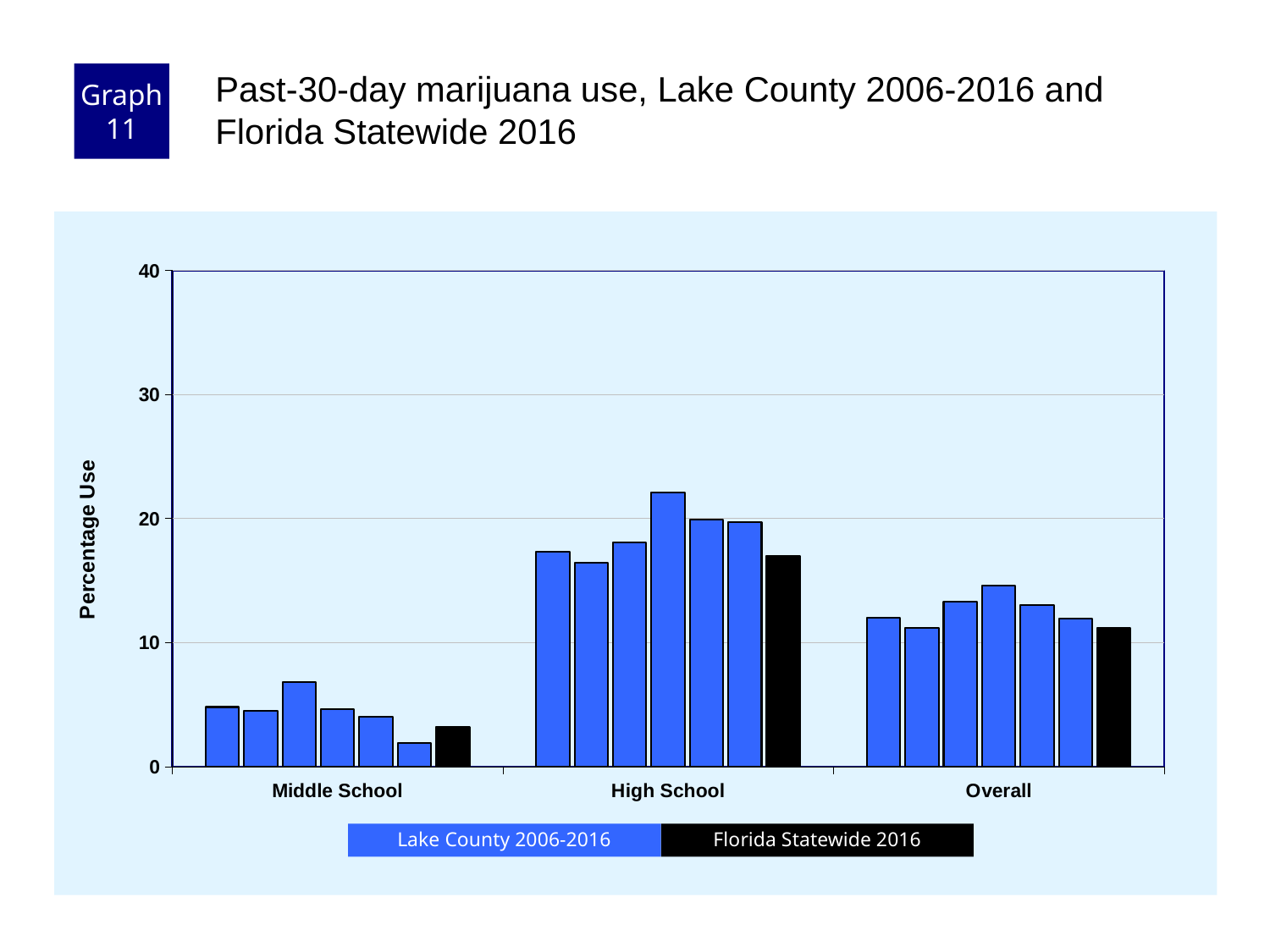
How many series does the legend list? 2 Do the Lake County 2006-2016 bars for Middle School end higher or lower than they start? lower Is the Florida Statewide 2016 value for Overall greater or less than 10? greater Which category has the lowest bars overall? Middle School Is the Florida Statewide 2016 value for High School greater or less than 20? less What is the label on the y axis? Percentage Use How many categories are shown on the x axis? 3 Which category has the highest bars overall? High School Which is larger, the Florida Statewide 2016 value for High School or for Overall? High School What kind of chart is shown on the slide? bar chart Is the Florida Statewide 2016 value for High School greater or less than 10? greater